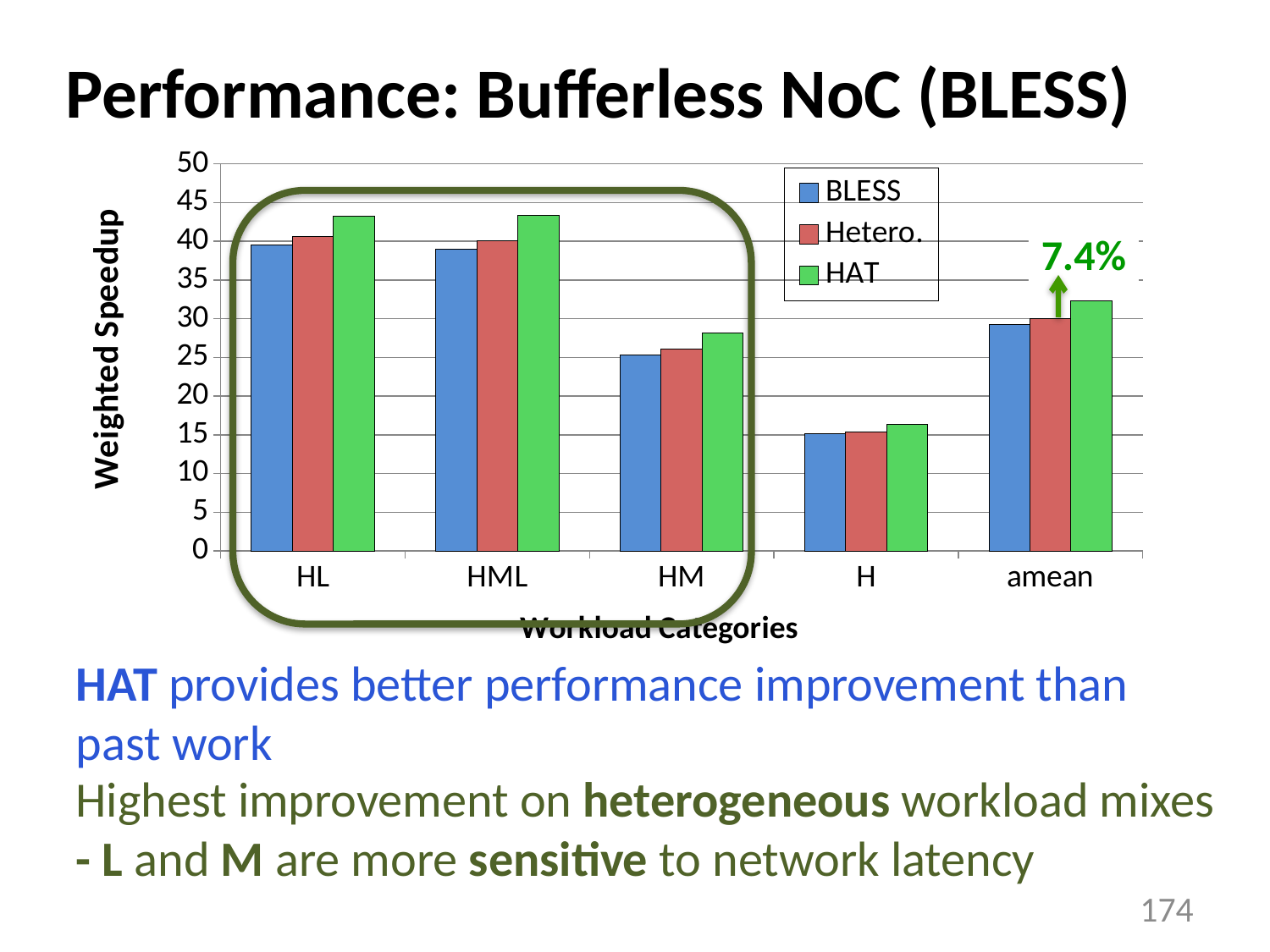
How many series does the legend list? 3 What kind of chart is shown on the slide? bar chart Is the HAT value for amean greater or less than 30? greater Is the BLESS value for H greater or less than 20? less Which workload category has the lowest weighted speedup for all three series? H How many workload categories are shown on the x axis? 5 What is the label of the y axis? Weighted Speedup What percentage improvement is annotated above the amean bars? 7.4% For the HM category, which is larger, the BLESS value or the HAT value? HAT Is the BLESS value for HM greater or less than 30? less Which is larger, the BLESS value for HL or the BLESS value for H? HL